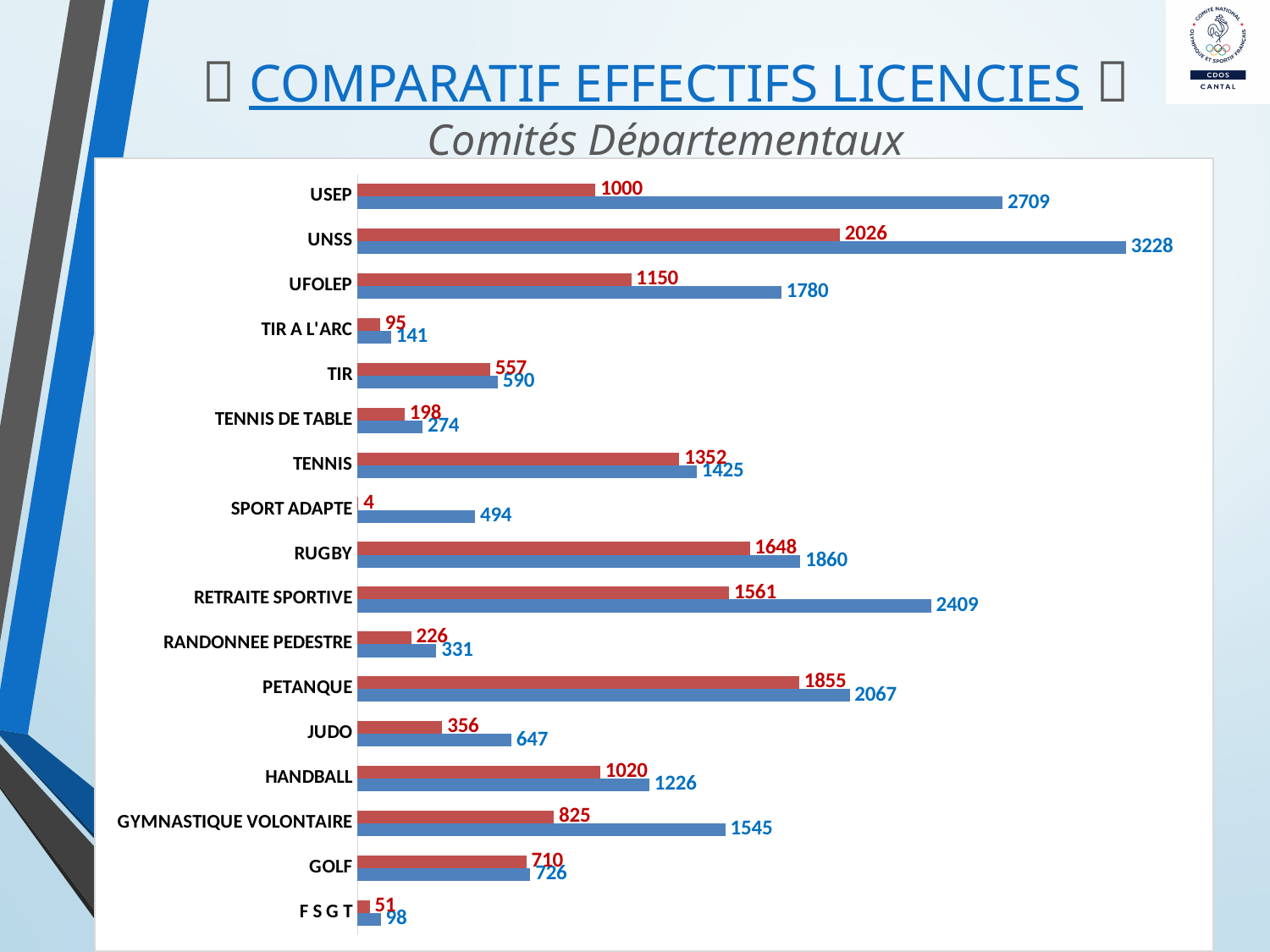
What is the value of the red bar for USEP? 1000 What is the value of the red bar for SPORT ADAPTE? 4 What is the value of the blue bar for UNSS? 3228 Which category has the highest blue bar value? UNSS What is the subtitle shown below the chart title? Comités Départementaux Which is larger: the blue bar for PETANQUE or the blue bar for RUGBY? PETANQUE What type of chart is shown on the slide? bar chart What is the difference between the blue and red bar values for USEP? 1709 What is the value of the blue bar for RETRAITE SPORTIVE? 2409 Which category has the lowest red bar value? SPORT ADAPTE How many categories (comités) are shown in the chart? 17 Which category has the lowest blue bar value? F S G T